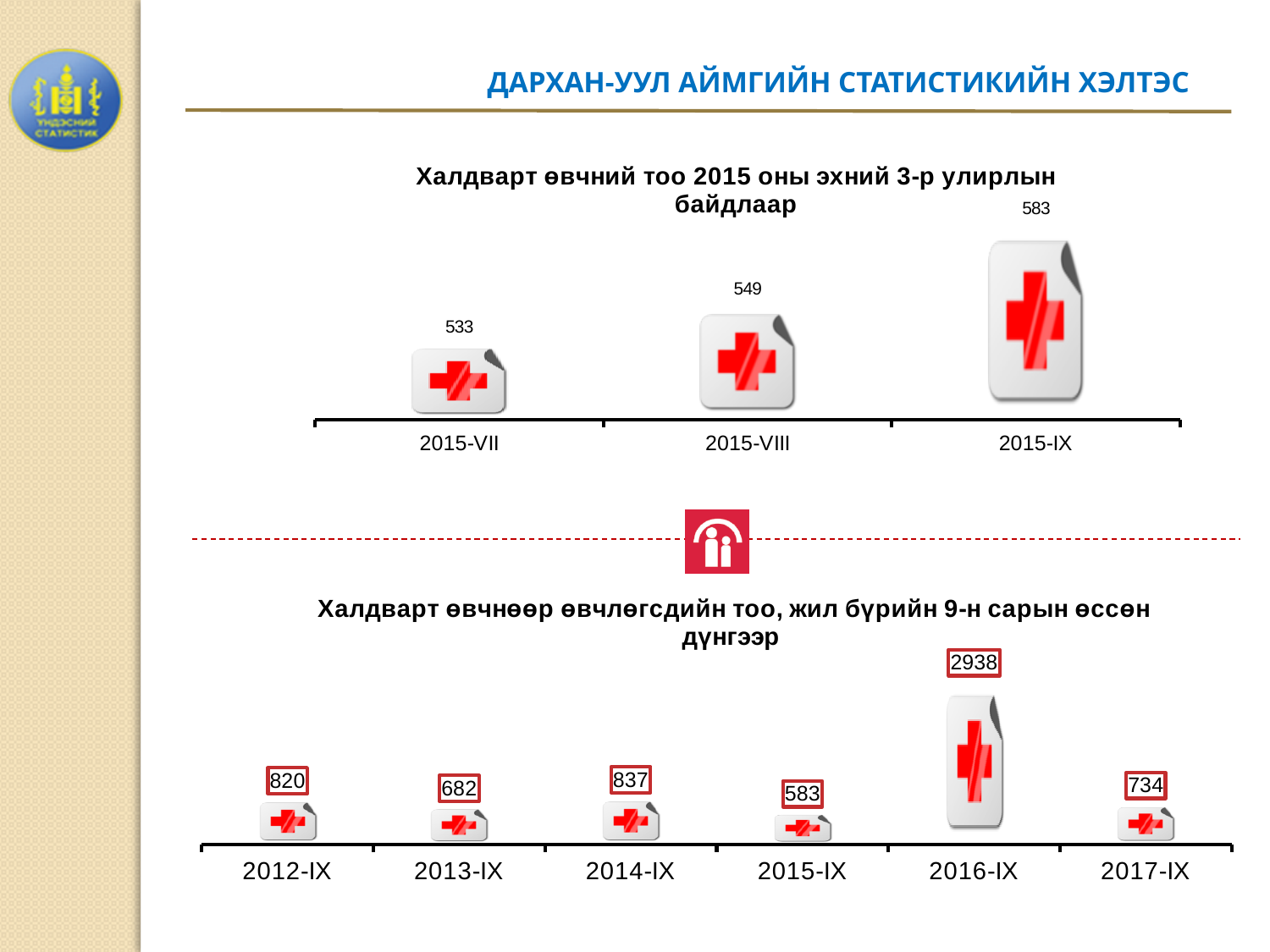
In the bottom chart, what is the value for 2016-IX? 2938 How many categories are shown in the bottom chart? 6 In the bottom chart, what is the value for 2013-IX? 682 In the bottom chart, which year has the lowest value? 2015-IX In the top chart, what is the value for 2015-VIII? 549 In the top chart, what is the difference between the values for 2015-IX and 2015-VII? 50 How many categories are shown in the top chart? 3 In the bottom chart, what is the difference between the values for 2016-IX and 2017-IX? 2204 In the top chart, do the values rise or fall from 2015-VII to 2015-IX? rise In the bottom chart, which is larger, the value for 2012-IX or 2014-IX? 2014-IX What kind of chart is the bottom chart? bar chart In the top chart, which month has the highest value? 2015-IX